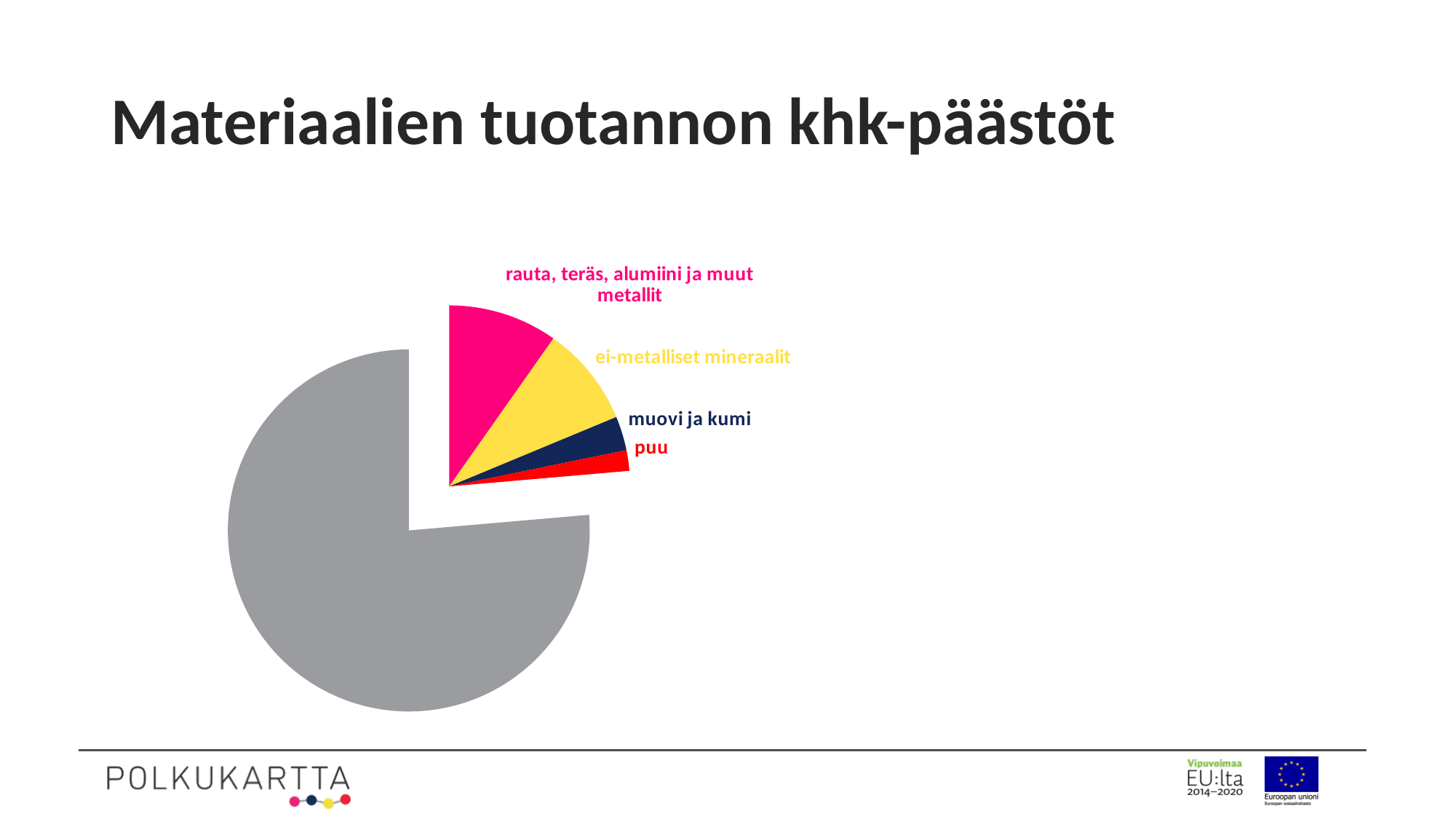
Which slice is larger: 'rauta, teräs, alumiini ja muut metallit' or 'ei-metalliset mineraalit'? rauta, teräs, alumiini ja muut metallit Which slice is larger: 'muovi ja kumi' or 'puu'? muovi ja kumi Which slice is larger: 'puu' or 'rauta, teräs, alumiini ja muut metallit'? rauta, teräs, alumiini ja muut metallit What is the title of the slide containing the pie chart? Materiaalien tuotannon khk-päästöt What colour is the 'puu' slice in the pie chart? red How many labelled slices are pulled out from the pie chart? 4 Among the labelled slices of the pie chart, which one is the smallest? puu What kind of chart is shown on the slide? pie chart Among the labelled slices of the pie chart, which one is the largest? rauta, teräs, alumiini ja muut metallit